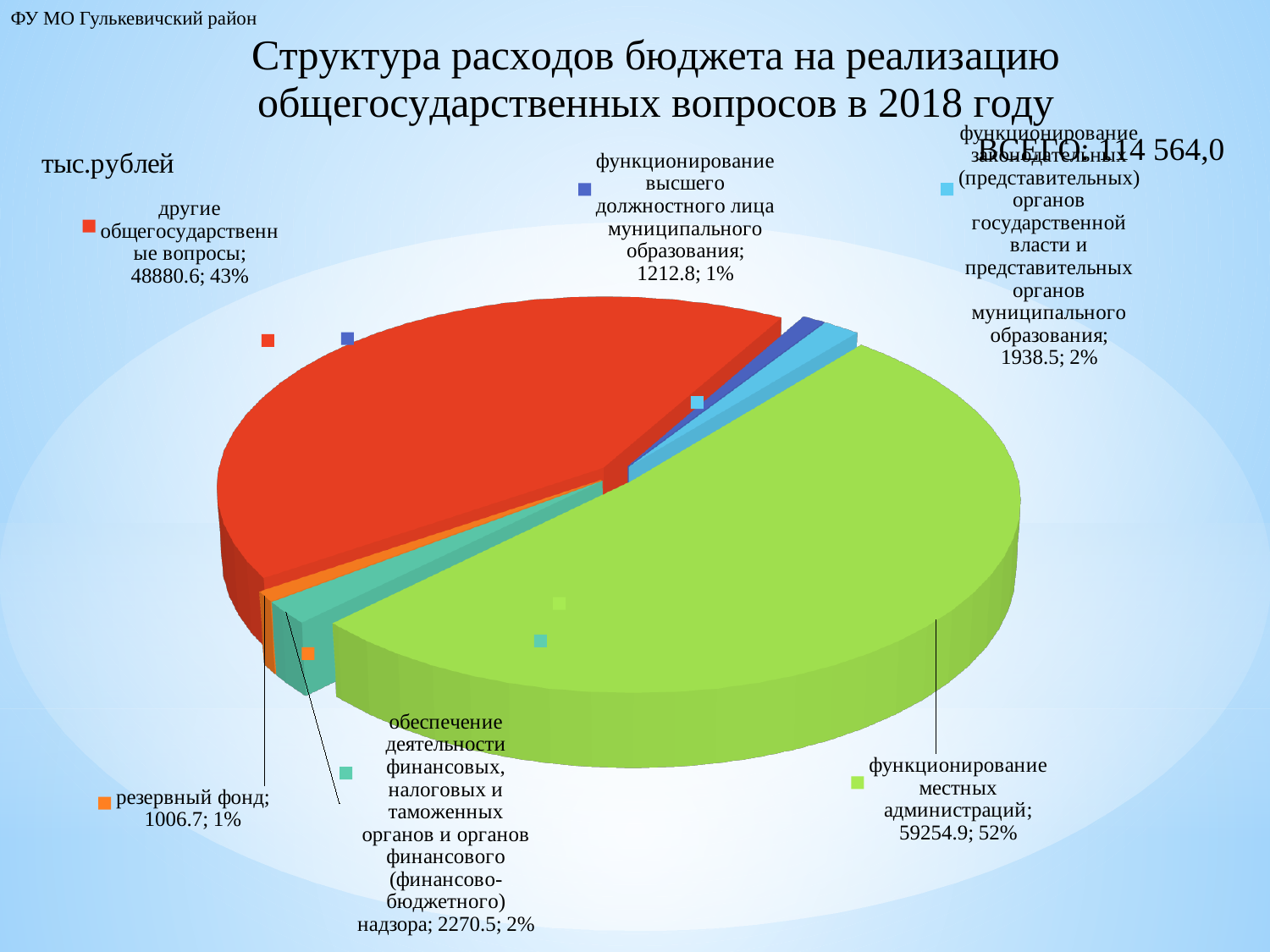
What total (ВСЕГО) is shown on the slide? 114 564,0 What share of the pie does 'функционирование местных администраций' represent? 52% What is the difference between the values for 'функционирование местных администраций' and 'другие общегосударственные вопросы'? 10374.3 Which is larger: the value for 'функционирование законодательных (представительных) органов...' or the value for 'функционирование высшего должностного лица муниципального образования'? функционирование законодательных (представительных) органов How many slices does the pie chart have? 6 Which category has the largest slice of the pie? функционирование местных администраций What is the value for 'резервный фонд'? 1006.7 What is the value for 'функционирование местных администраций'? 59254.9 What share of the pie does 'другие общегосударственные вопросы' represent? 43% What kind of chart is shown on the slide? pie chart In what units are the values on the chart given? тыс.рублей Which category has the smallest value in the pie chart? резервный фонд